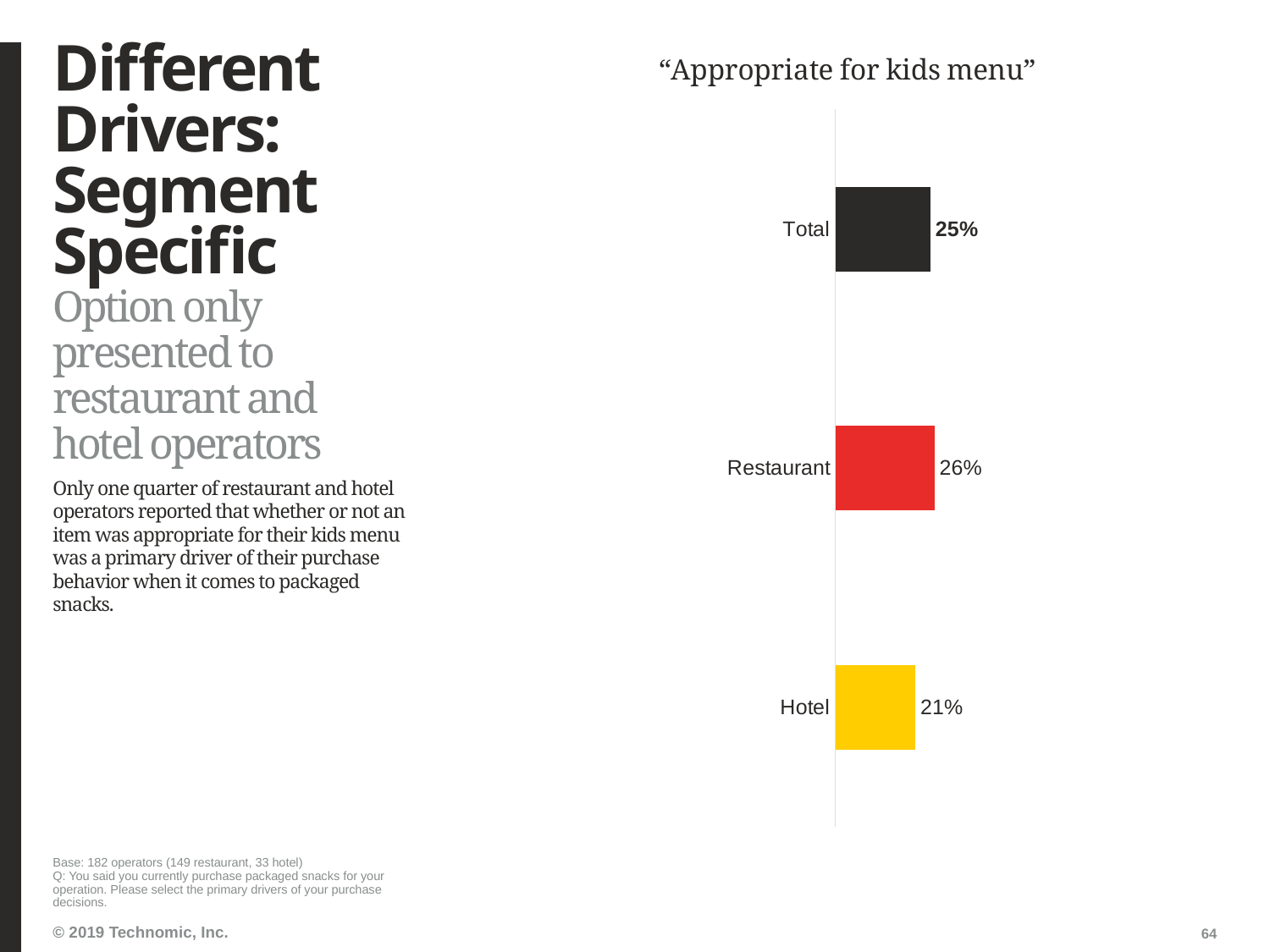
What is the difference between the Total and Hotel values? 4% What is the difference between the Restaurant and Hotel values? 5% What is the value for Total? 25% What is the value for Restaurant? 26% Which category has the highest value? Restaurant What is the title of the chart? "Appropriate for kids menu" How many categories are shown in the chart? 3 What colour is the Hotel bar? Yellow Which category has the lowest value? Hotel What kind of chart is shown on the slide? Bar chart Which is larger, the value for Restaurant or the value for Hotel? Restaurant What is the value for Hotel? 21%